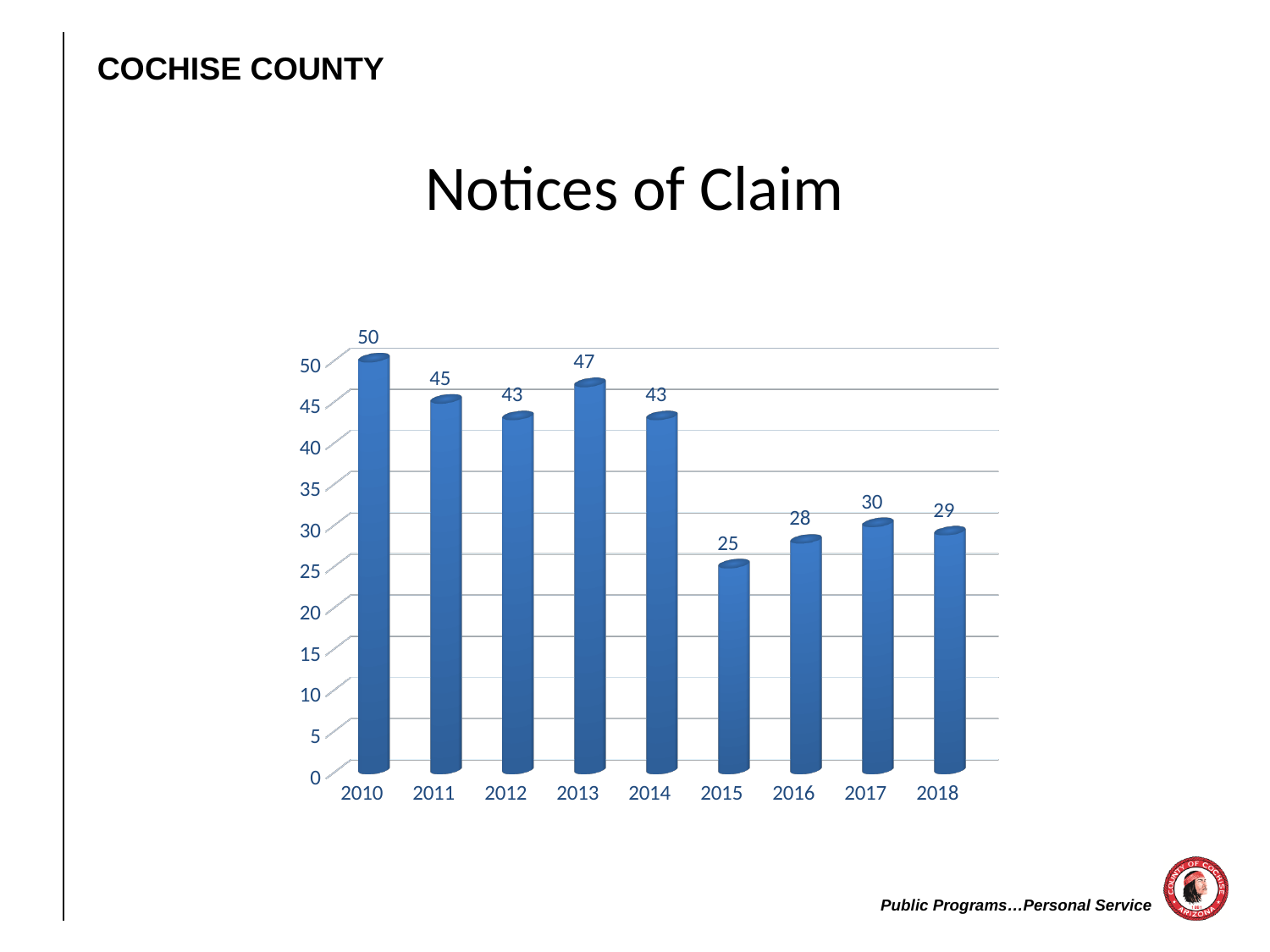
What is the difference between the values for 2010 and 2015? 25 Which year has the highest value? 2010 What is the value for 2010? 50 What is the value for 2015? 25 What is the value for 2017? 30 Is the value for 2013 greater or less than 40? greater What kind of chart is shown? bar chart What is the difference between the values for 2013 and 2014? 4 Which year has the lowest value? 2015 Which is larger, the value for 2011 or the value for 2016? 2011 How many years are shown on the x axis? 9 What is the title of the chart? Notices of Claim